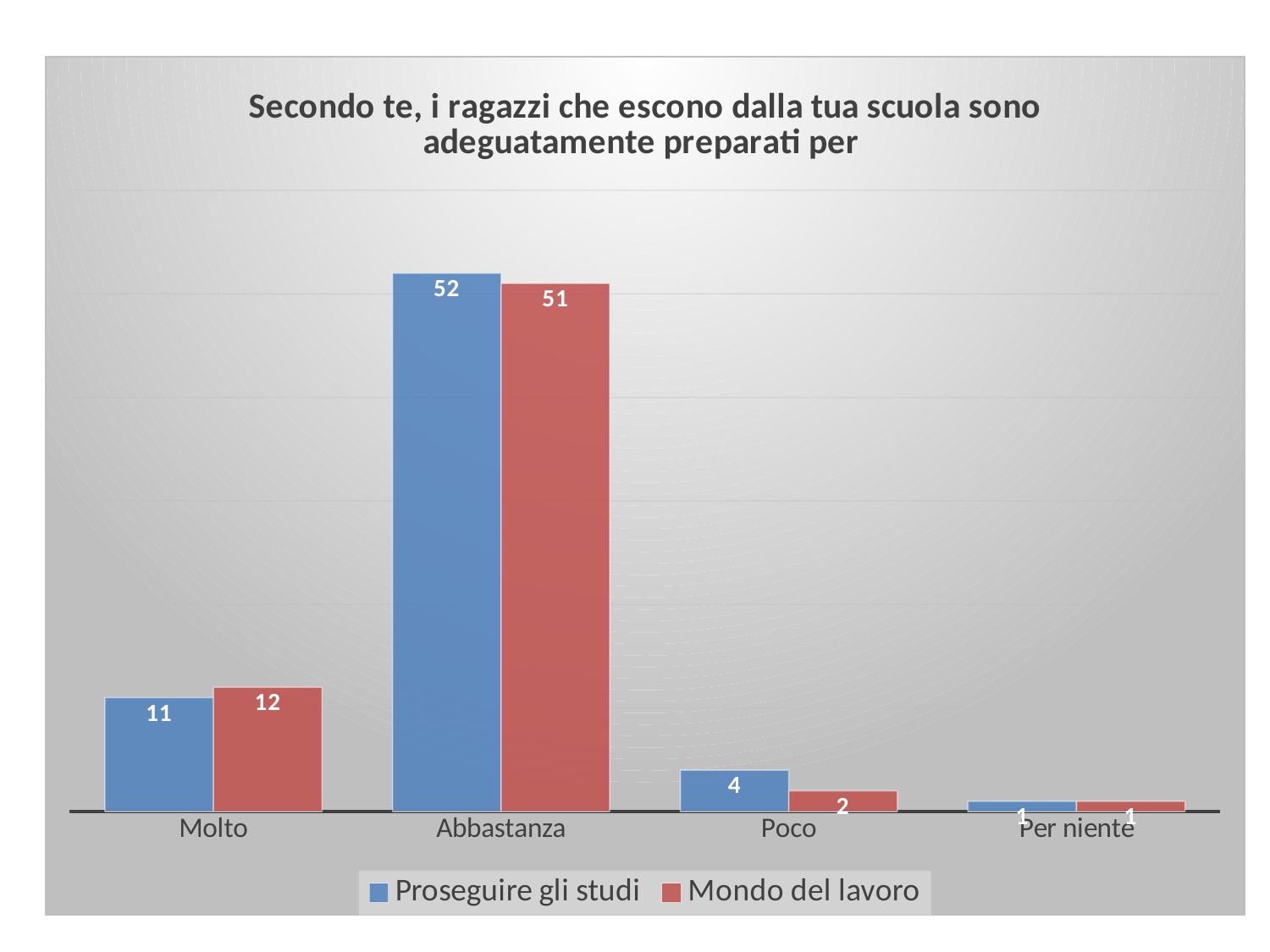
How many series does the legend list? 2 What is the value for 'Proseguire gli studi' in the 'Abbastanza' category? 52 Which category has the highest value for 'Proseguire gli studi'? Abbastanza What is the difference between 'Proseguire gli studi' and 'Mondo del lavoro' in the 'Poco' category? 2 What is the title of the chart? Secondo te, i ragazzi che escono dalla tua scuola sono adeguatamente preparati per What is the value for 'Mondo del lavoro' in the 'Molto' category? 12 Which colour represents the 'Mondo del lavoro' series? Red In the 'Molto' category, which series has the larger value, 'Proseguire gli studi' or 'Mondo del lavoro'? Mondo del lavoro Which category has the lowest value for 'Mondo del lavoro'? Per niente How many categories are shown on the x axis? 4 What kind of chart is shown on the slide? Bar chart What is the value for 'Mondo del lavoro' in the 'Poco' category? 2